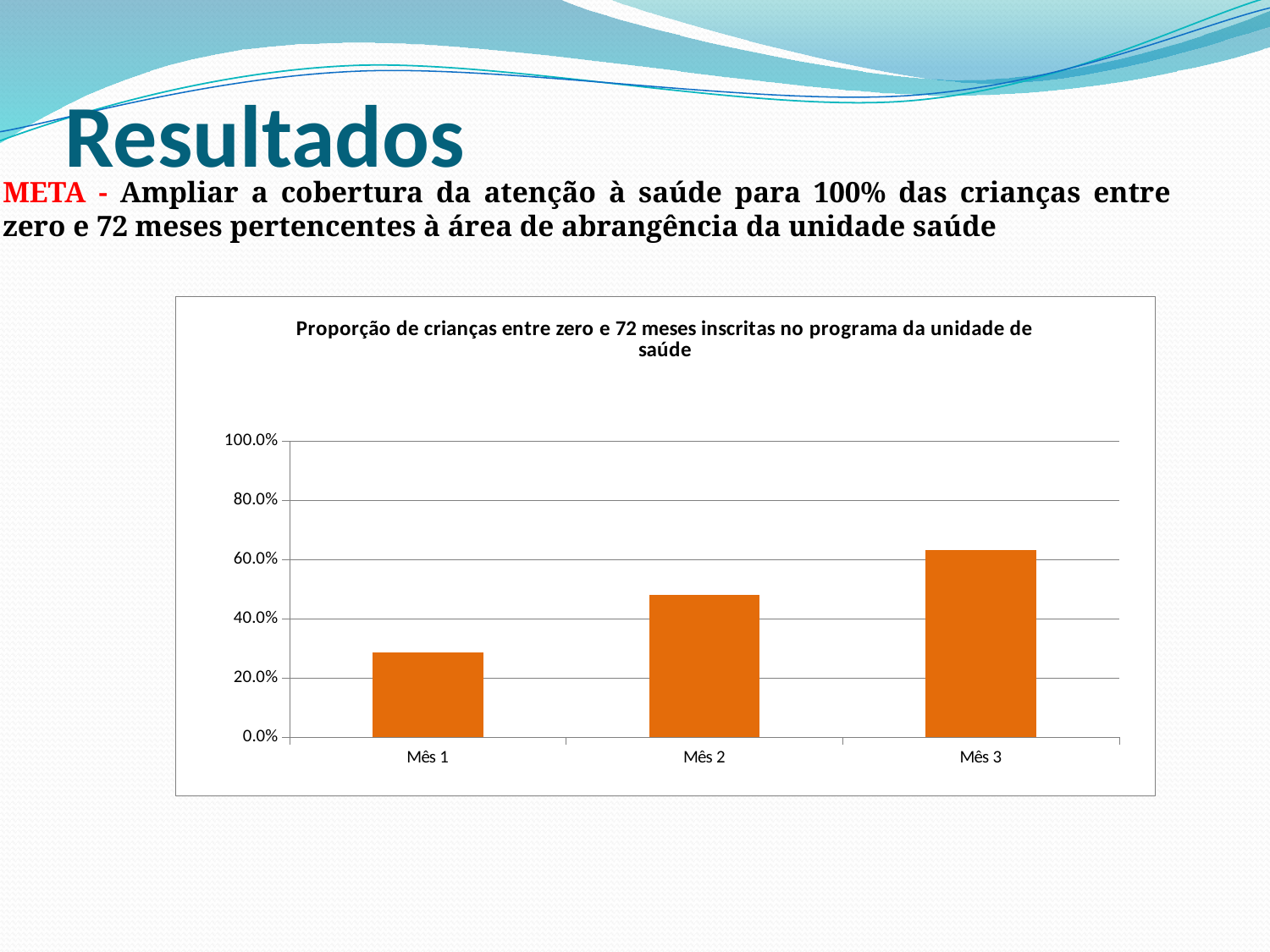
Is the value for Mês 1 greater or less than 40.0%? less Is the value for Mês 2 greater or less than 60.0%? less Which month has the lowest value in the chart? Mês 1 Which is larger, the value for Mês 2 or the value for Mês 3? Mês 3 How many categories (months) are shown on the x axis of the chart? 3 Is the value for Mês 3 greater or less than 80.0%? less What is the title of the chart? Proporção de crianças entre zero e 72 meses inscritas no programa da unidade de saúde What type of chart is shown on the slide? bar chart Which month has the highest value in the chart? Mês 3 Do the values rise or fall from Mês 1 to Mês 3? rise